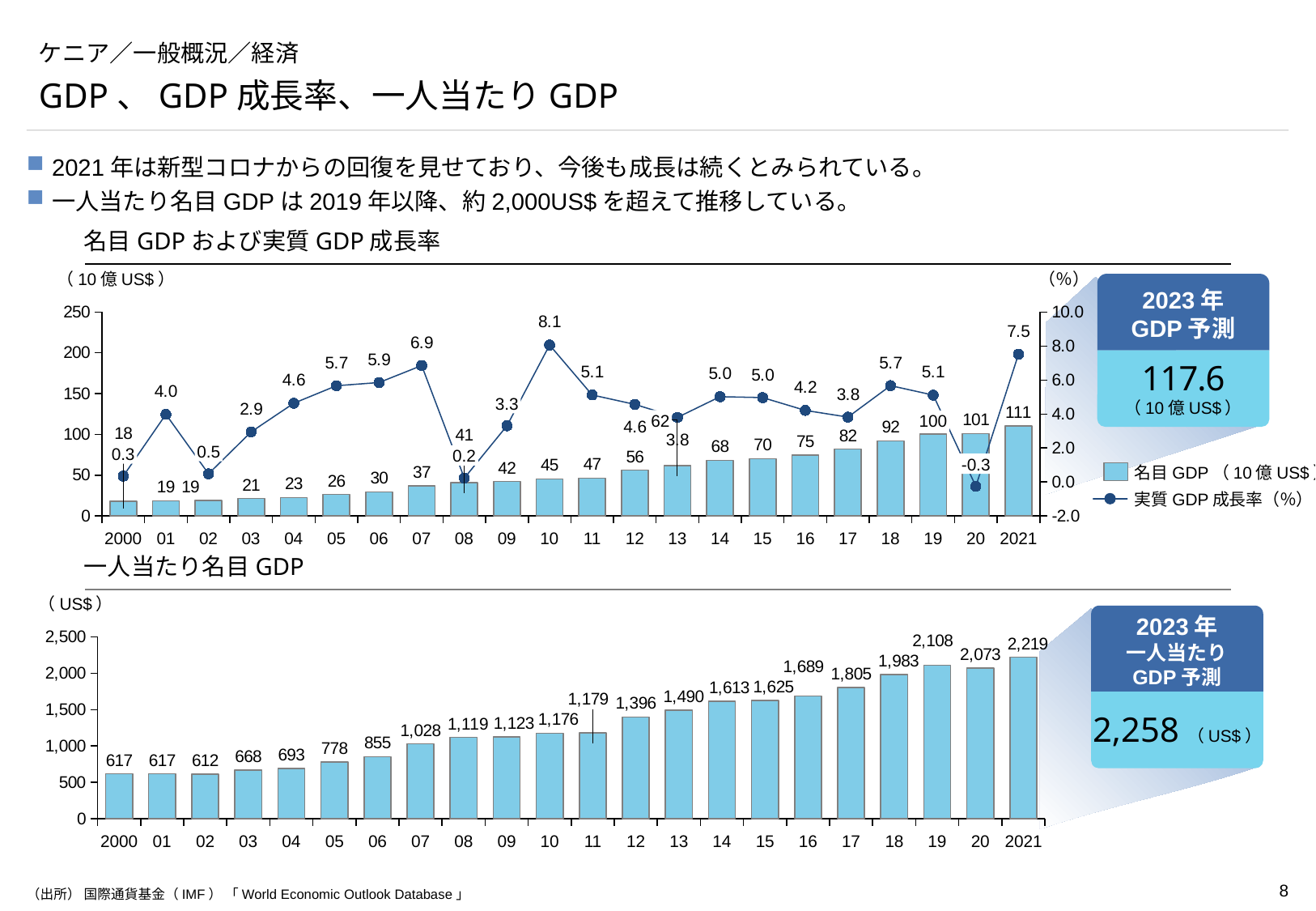
In the top chart (名目GDPおよび実質GDP成長率), what is the nominal GDP value for 2021? 111 In the bottom chart (一人当たり名目GDP), what is the value for 2019? 2,108 In the top chart (名目GDPおよび実質GDP成長率), is the real GDP growth rate higher in 2007 or in 2008? 2007 In the top chart (名目GDPおよび実質GDP成長率), what is the real GDP growth rate for 2010? 8.1 In the top chart (名目GDPおよび実質GDP成長率), which year has the lowest real GDP growth rate? 20 What type of chart is the bottom chart (一人当たり名目GDP)? Bar chart In the bottom chart (一人当たり名目GDP), how many years are plotted on the x axis? 22 In the top chart (名目GDPおよび実質GDP成長率), what is the difference in nominal GDP between 2021 and 2000? 93 In the bottom chart (一人当たり名目GDP), what is the difference between the values for 2021 and 20? 146 In the bottom chart (一人当たり名目GDP), which year has the lowest value? 02 In the top chart (名目GDPおよび実質GDP成長率), how many series does the legend list? 2 In the bottom chart (一人当たり名目GDP), which year has the highest value? 2021